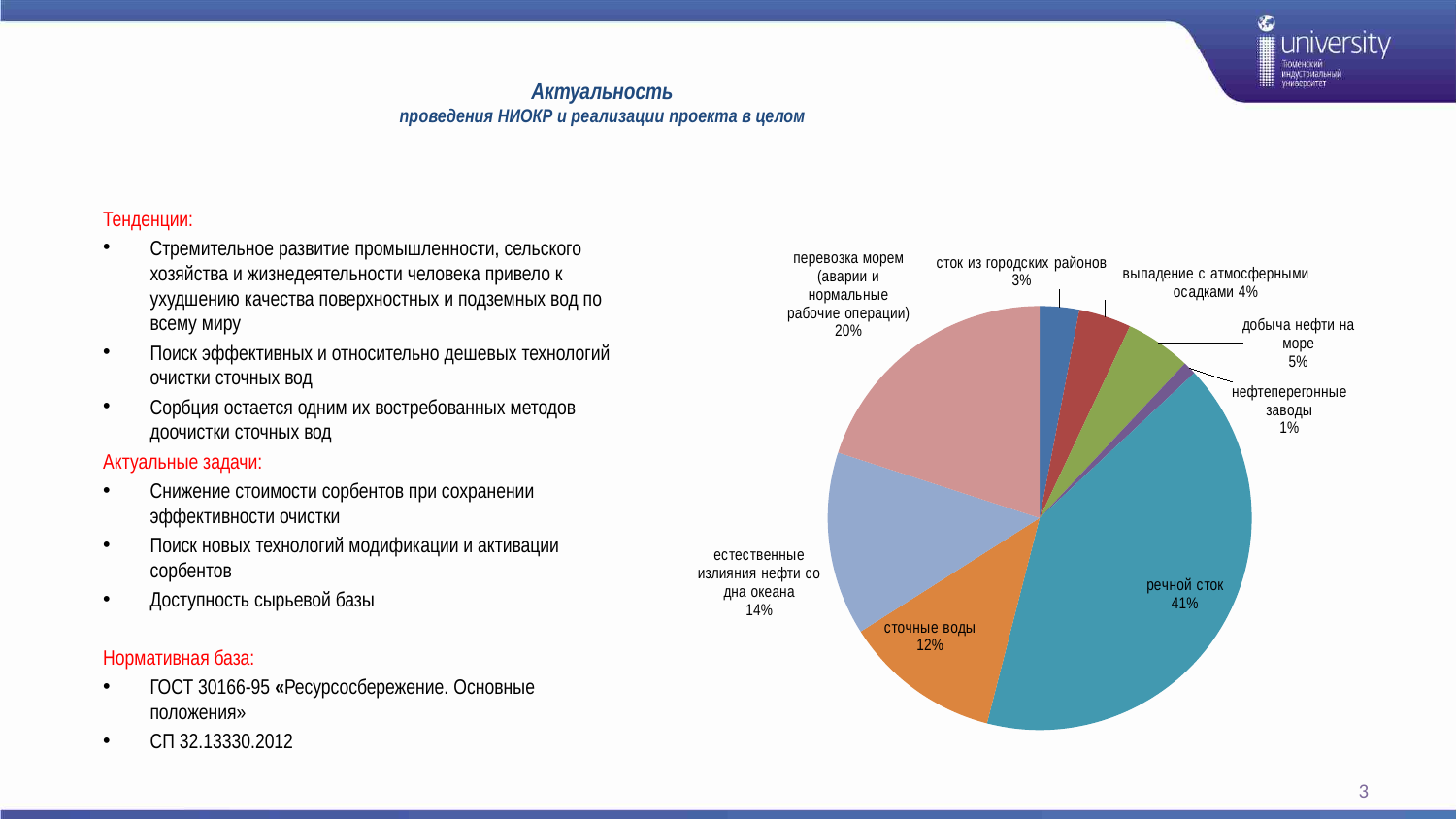
What is the difference between the shares of "речной сток" and "перевозка морем (аварии и нормальные рабочие операции)"? 21% What is the value shown for "сток из городских районов"? 3% How many slices does the pie chart have? 8 What is the value shown for "перевозка морем (аварии и нормальные рабочие операции)"? 20% What type of chart is shown on the slide? pie chart Which category has the smallest slice of the pie? нефтеперегонные заводы What is the combined share of "сточные воды" and "естественные излияния нефти со дна океана"? 26% Which category has the largest slice of the pie? речной сток What is the value shown for "сточные воды"? 12% What is the value shown for "естественные излияния нефти со дна океана"? 14% What share of the pie does "речной сток" have? 41% Which is larger: "добыча нефти на море" or "выпадение с атмосферными осадками"? добыча нефти на море